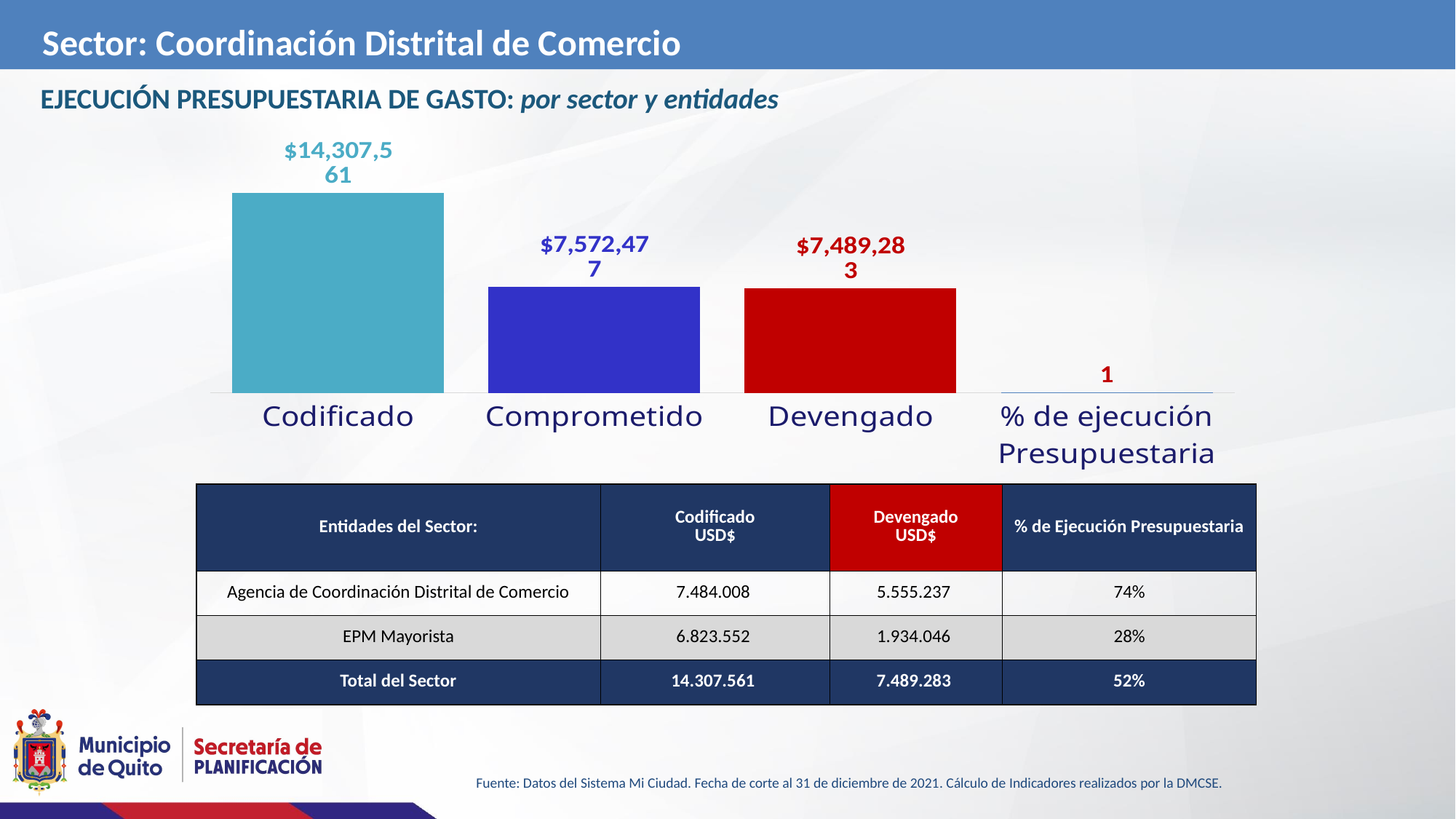
How many categories are shown on the x axis of the chart? 4 What colour is the Devengado bar? red What is the value of the Comprometido bar? $7,572,477 What value is labelled for the '% de ejecución Presupuestaria' category? 1 What is the value of the Codificado bar? $14,307,561 What is the value of the Devengado bar? $7,489,283 Which category has the highest value in the chart? Codificado Which category has the lowest value in the chart? % de ejecución Presupuestaria What is the difference between the Comprometido and Devengado values? $83,194 What is the difference between the Codificado and Comprometido values? $6,735,084 Which is larger, the Comprometido value or the Devengado value? Comprometido What type of chart is shown on the slide? bar chart